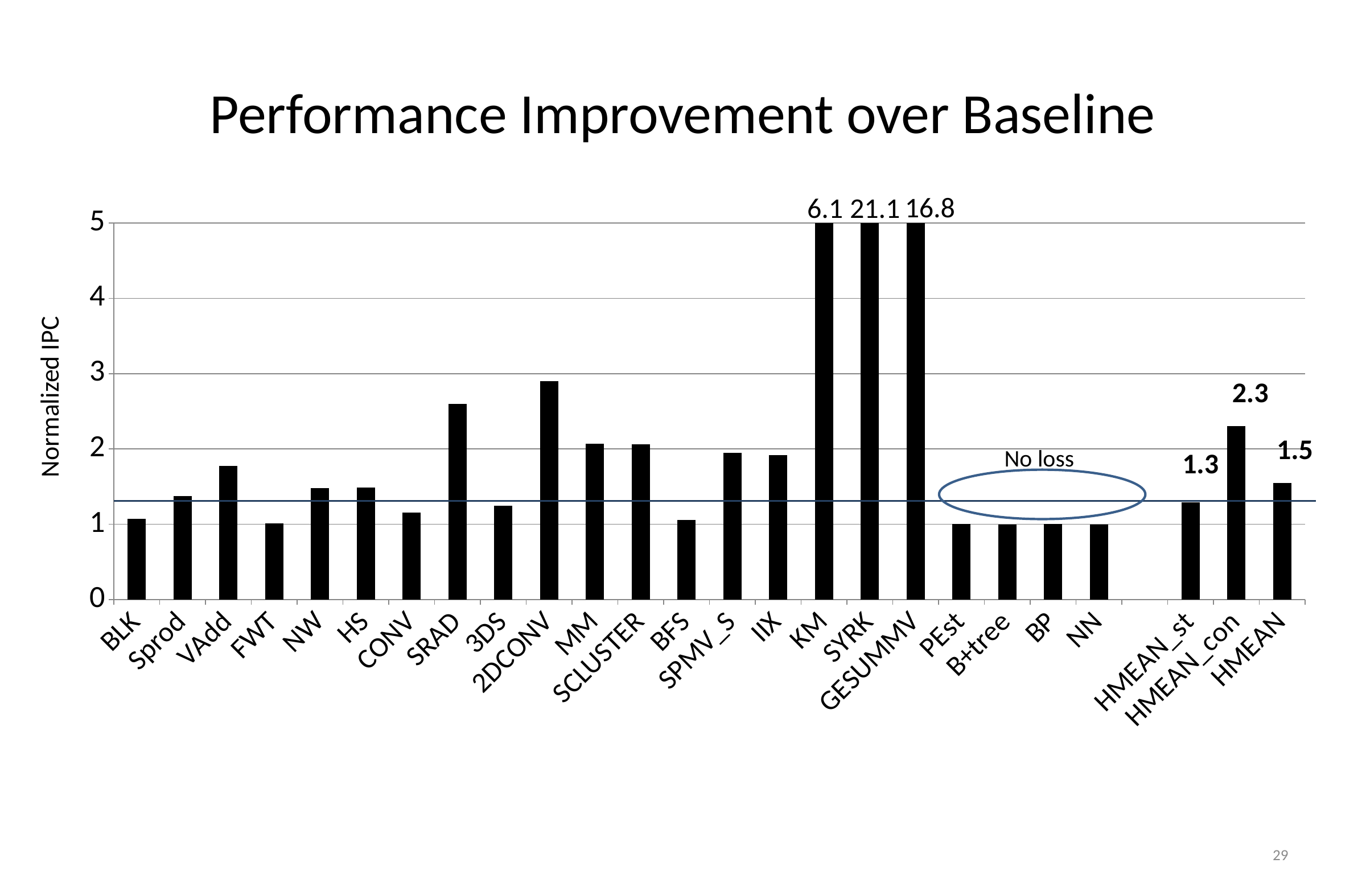
Which category has the highest Normalized IPC? SYRK What is the value shown for HMEAN? 1.5 What kind of chart is shown on the slide? bar chart What is the Normalized IPC value for SYRK? 21.1 What is the Normalized IPC value for KM? 6.1 Is the value for BLK greater or less than 2? less Which has a larger Normalized IPC, KM or GESUMMV? GESUMMV What is the Normalized IPC value for GESUMMV? 16.8 What is the difference between the values for SYRK and GESUMMV? 4.3 How many categories are shown on the x axis? 25 Is the value for 2DCONV greater or less than 2? greater What is the value shown for HMEAN_con? 2.3